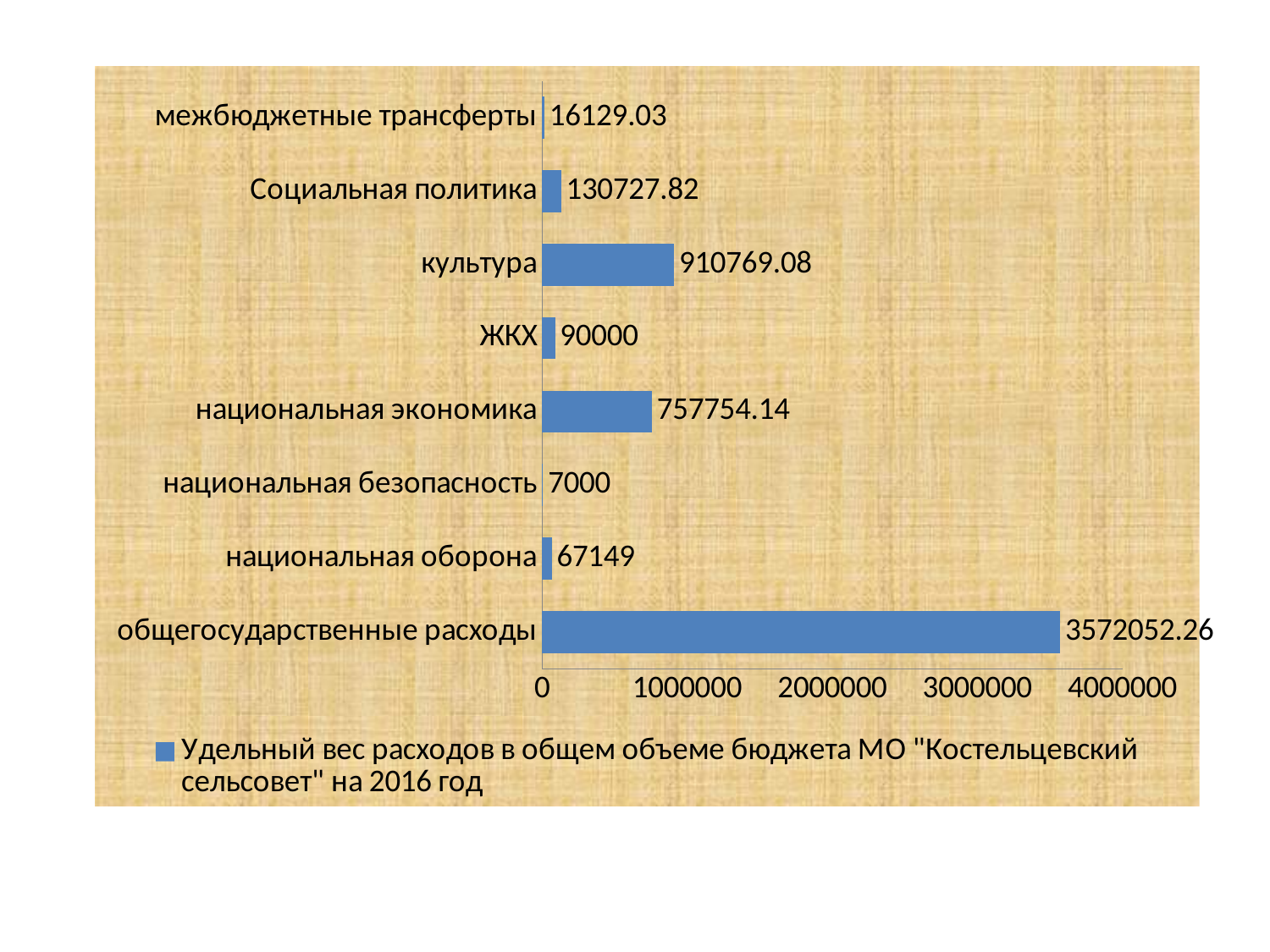
How many series does the legend list? 1 What is the value for общегосударственные расходы? 3572052.26 What is the value for ЖКХ? 90000 Which is larger, the value for Социальная политика or the value for ЖКХ? Социальная политика Which category has the lowest value? национальная безопасность What kind of chart is shown on the slide? Bar chart What is the value for национальная экономика? 757754.14 What is the difference between the values for культура and национальная экономика? 153014.94 What is the difference between the values for ЖКХ and национальная оборона? 22851 What is the value for культура? 910769.08 Which category has the highest value? общегосударственные расходы How many categories are shown in the chart? 8